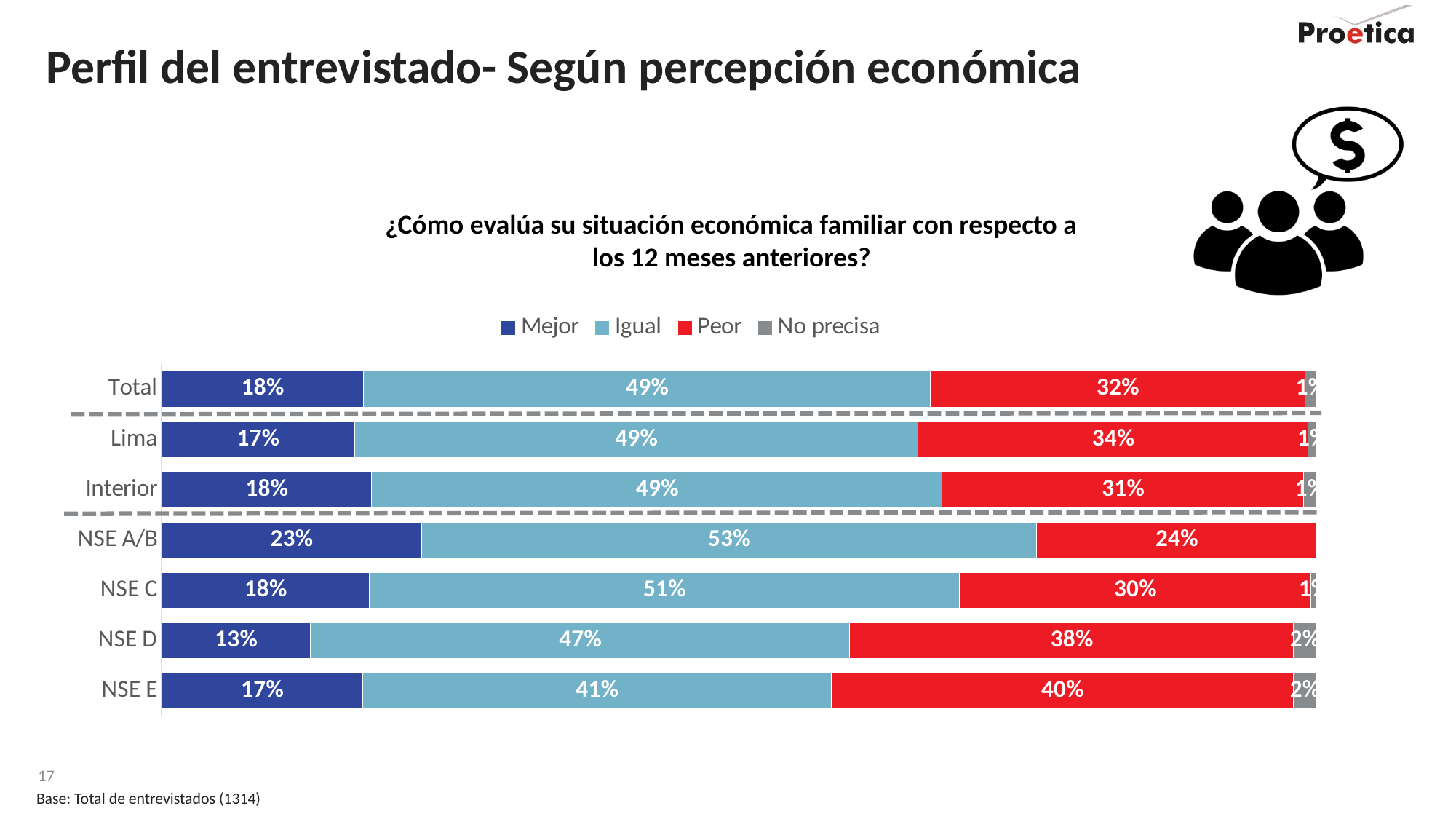
Which category has the lowest "Igual" percentage? NSE E How many categories are shown on the chart? 7 Which category has the highest "Peor" percentage? NSE E What kind of chart is shown on the slide? Stacked bar chart Which has a larger "Igual" value, NSE C or NSE D? NSE C What is the "Peor" value for NSE E? 40% How many percentage points higher is the "Peor" value for Lima than for Interior? 3 percentage points Which category has the lowest "Mejor" percentage? NSE D Which category has the highest "Mejor" percentage? NSE A/B What percentage of NSE A/B respondents answered "Mejor"? 23% What is the "Igual" value for NSE D? 47% How many series does the legend list? 4